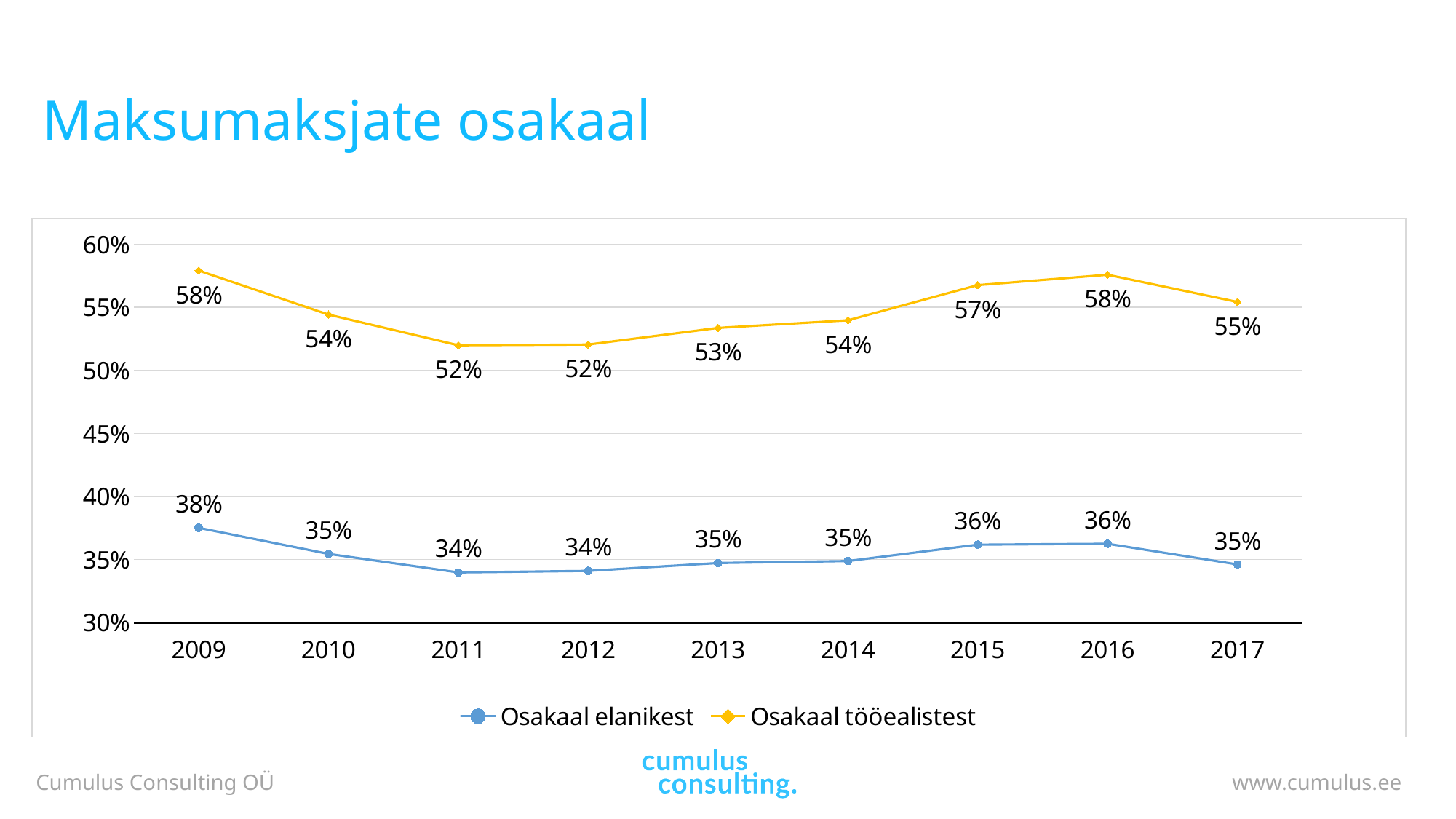
How many years are shown on the x axis? 9 What is the difference between Osakaal tööealistest and Osakaal elanikest in 2009? 20 percentage points What is the title of the slide? Maksumaksjate osakaal What is the value of Osakaal elanikest in 2009? 38% Does Osakaal tööealistest rise or fall from 2012 to 2016? rise What is the value of Osakaal tööealistest in 2015? 57% In which year is Osakaal elanikest highest? 2009 What is the value of Osakaal tööealistest in 2017? 55% How many series does the legend list? 2 What kind of chart is shown on the slide? line chart Which is larger for Osakaal elanikest: the value in 2015 or the value in 2017? 2015 Is the value for Osakaal tööealistest in 2011 greater or less than 55%? less